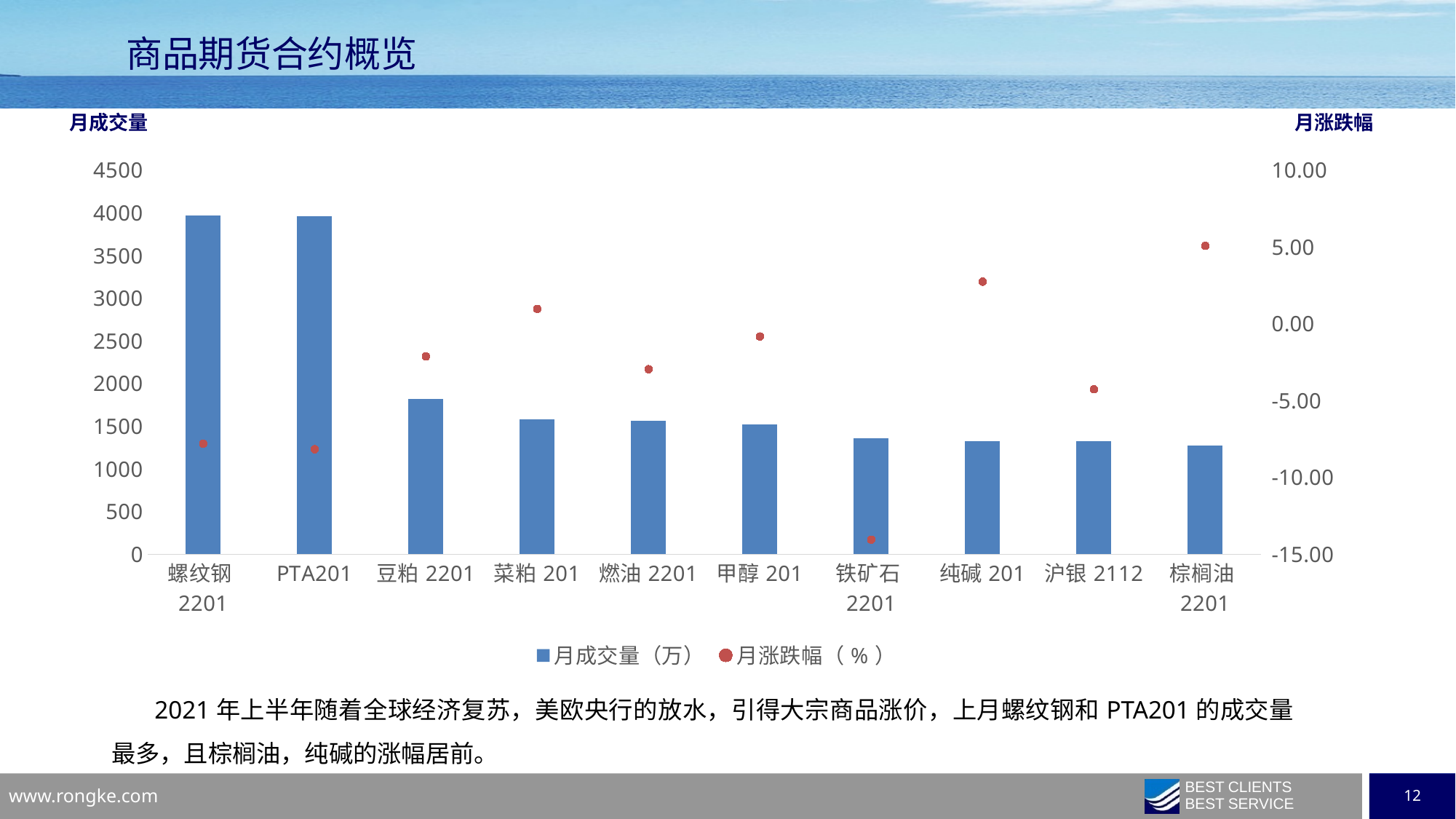
What kind of chart is shown on the slide? A combination chart of bars with dot markers on a secondary axis Is the 月成交量 bar for 螺纹钢 2201 greater or less than 3500? greater Which has the larger 月成交量 bar, 豆粕 2201 or 菜粕 201? 豆粕 2201 How many categories are shown on the x axis of the chart? 10 How many series does the chart legend list? 2 Is the 月涨跌幅 value for 纯碱 201 greater or less than 0.00? greater Do the 月成交量 bars generally rise or fall from left to right across the x axis? fall Is the 月成交量 bar for 豆粕 2201 greater or less than 2000? less What are the two series listed in the chart legend? 月成交量（万） and 月涨跌幅（%） Which category has the highest 月涨跌幅 (red dot) value? 棕榈油 2201 Which category has the lowest 月涨跌幅 (red dot) value? 铁矿石 2201